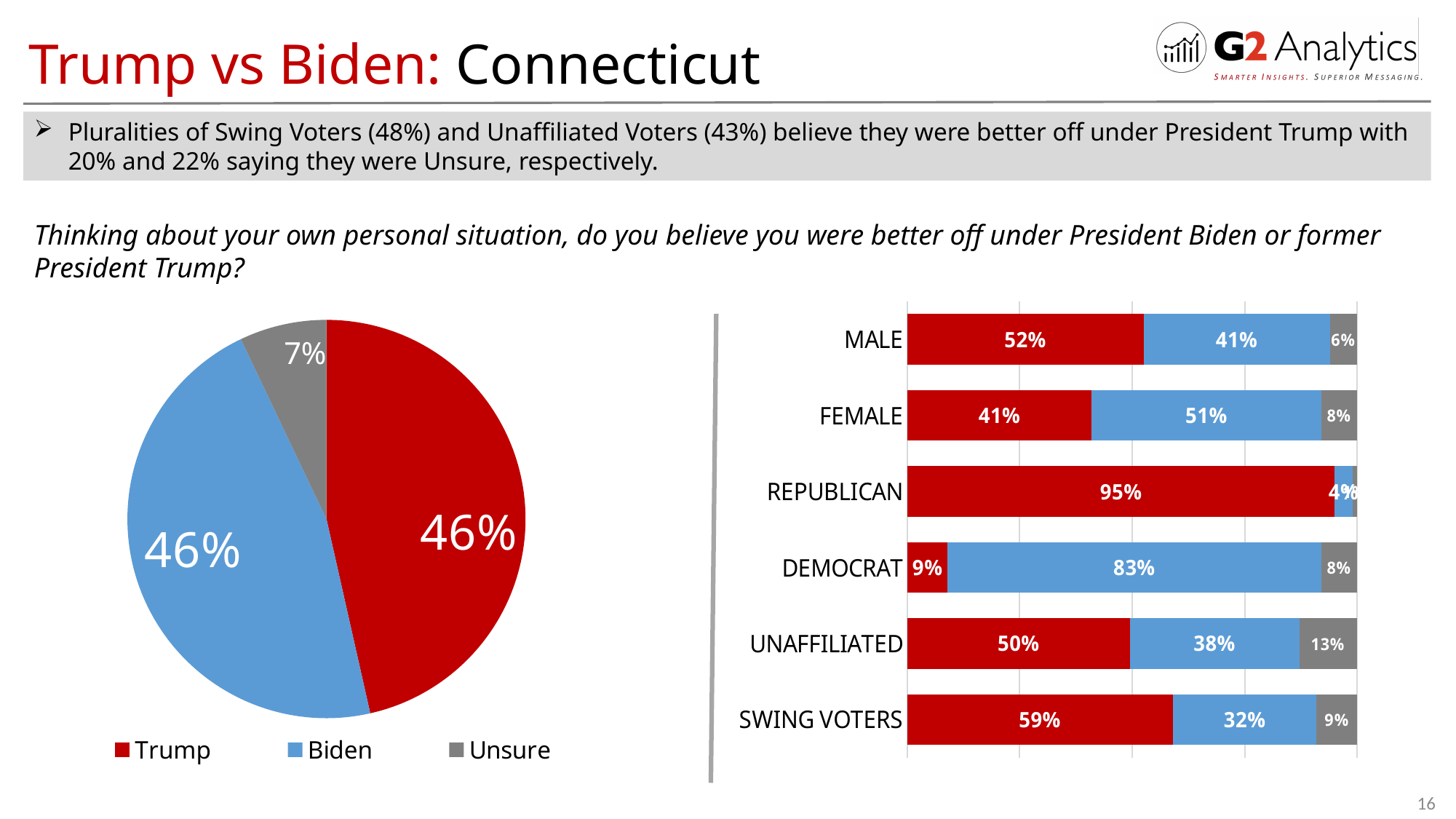
How many entries does the legend of the pie chart list? 3 In the pie chart, what share of respondents said they were better off under Trump? 46% In the pie chart, what percentage of respondents were Unsure? 7% What type of chart is on the left side of the slide? Pie chart In the bar chart on the right, is the Biden percentage larger for Male or Female respondents? Female In the bar chart on the right, what percentage of Unaffiliated voters were Unsure? 13% How many groups are shown in the bar chart on the right? 6 In the bar chart on the right, what percentage of Republicans said they were better off under Trump? 95% In the bar chart on the right, what is the difference between the Trump and Biden percentages for Swing Voters? 27% In the bar chart on the right, what percentage of Democrats said they were better off under Biden? 83% In the bar chart on the right, which group has the lowest Trump percentage? DEMOCRAT In the bar chart on the right, which group has the highest Trump percentage? REPUBLICAN